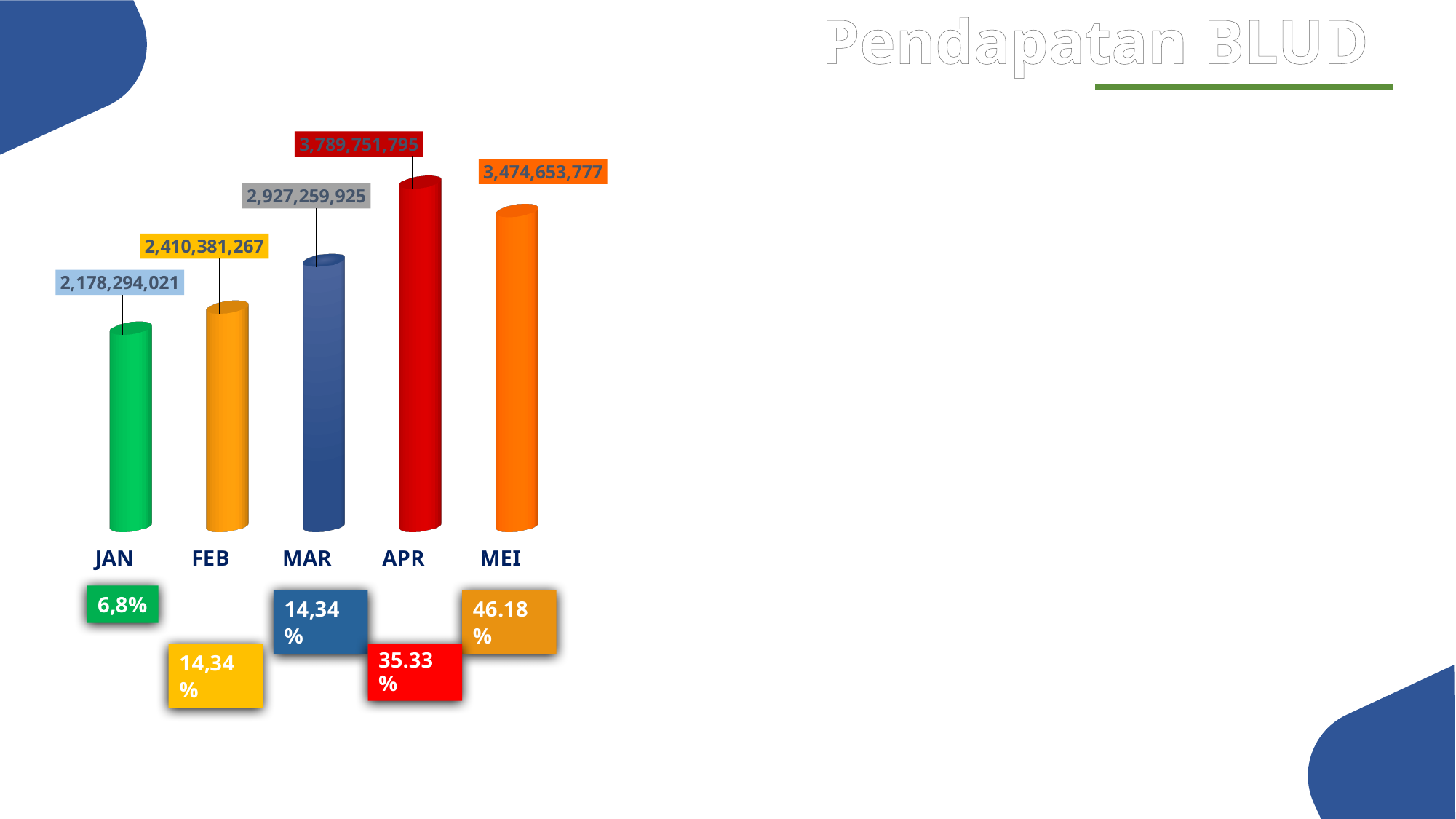
Which month has the highest value in the Pendapatan BLUD chart? APR What is the value for MAR in the Pendapatan BLUD chart? 2,927,259,925 What is the value for JAN in the Pendapatan BLUD chart? 2,178,294,021 Which month has the lowest value in the Pendapatan BLUD chart? JAN What kind of chart is shown on the slide? Bar chart What is the difference between the values for FEB and JAN in the Pendapatan BLUD chart? 232,087,246 What is the difference between the values for APR and MEI in the Pendapatan BLUD chart? 315,098,018 Do the values rise or fall from JAN to APR in the Pendapatan BLUD chart? Rise What is the value for MEI in the Pendapatan BLUD chart? 3,474,653,777 How many months are shown in the Pendapatan BLUD chart? 5 What is the title of the chart on the slide? Pendapatan BLUD Which is larger in the Pendapatan BLUD chart, the value for MAR or the value for MEI? MEI